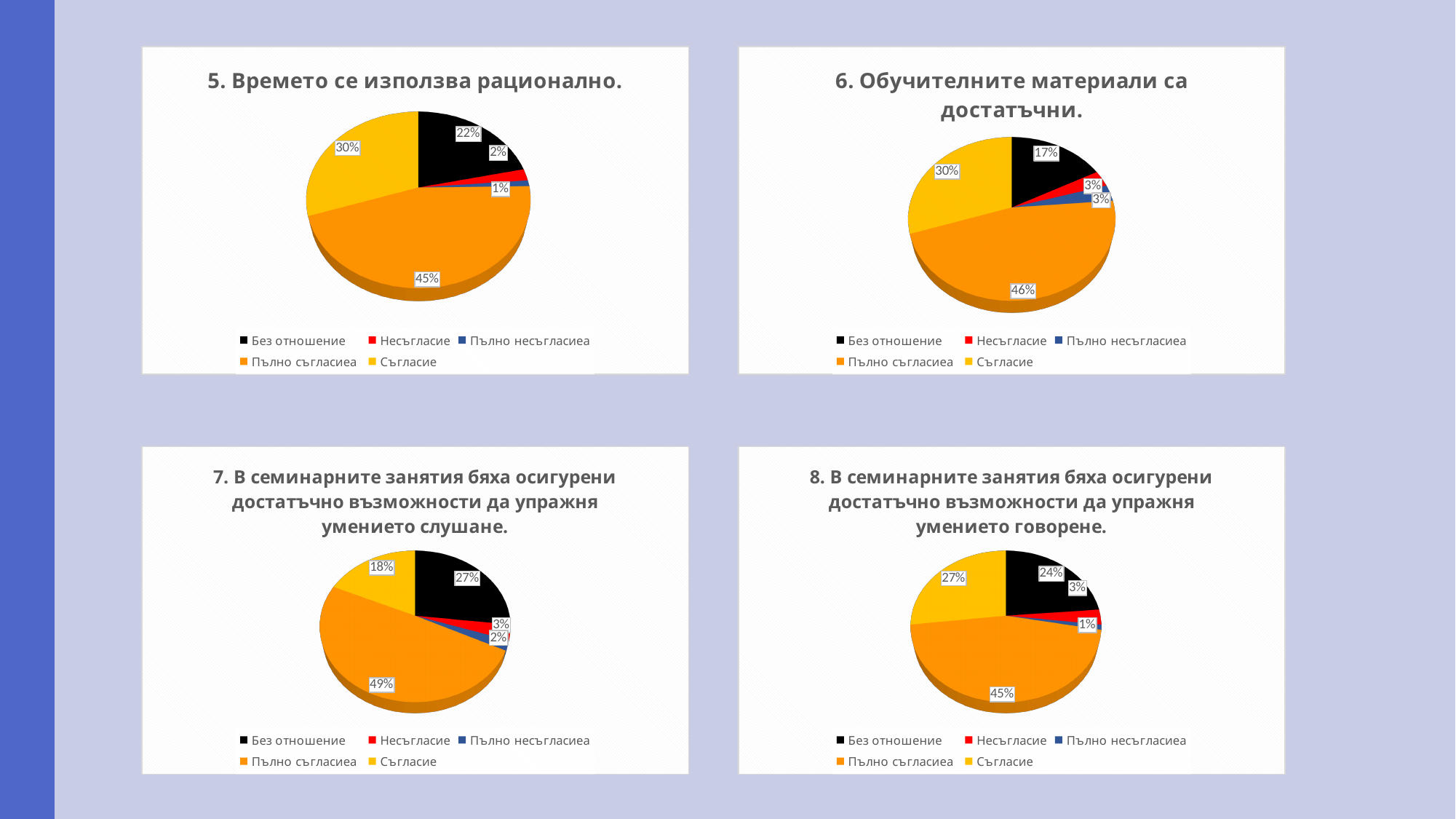
In the chart titled "6. Обучителните материали са достатъчни.", which category has the largest slice? Пълно съгласиеа In the chart titled "8. В семинарните занятия бяха осигурени достатъчно възможности да упражня умението говорене.", what is the value for "Пълно несъгласиеа"? 1% In the chart titled "8. В семинарните занятия бяха осигурени достатъчно възможности да упражня умението говорене.", which colour represents "Съгласие"? Yellow How many categories does the legend list in the chart titled "5. Времето се използва рационално."? 5 In the chart titled "5. Времето се използва рационално.", what share does "Пълно съгласиеа" have? 45% In the chart titled "7. В семинарните занятия бяха осигурени достатъчно възможности да упражня умението слушане.", what is the value for "Съгласие"? 18% In the chart titled "8. В семинарните занятия бяха осигурени достатъчно възможности да упражня умението говорене.", what is the difference between "Без отношение" and "Съгласие"? 3% What type of chart is the chart titled "7. В семинарните занятия бяха осигурени достатъчно възможности да упражня умението слушане."? Pie chart In the chart titled "5. Времето се използва рационално.", which category has the smallest slice? Пълно несъгласиеа In the chart titled "7. В семинарните занятия бяха осигурени достатъчно възможности да упражня умението слушане.", which is larger, "Без отношение" or "Съгласие"? Без отношение In the chart titled "6. Обучителните материали са достатъчни.", what is the value for "Без отношение"? 17% In the chart titled "6. Обучителните материали са достатъчни.", what is the difference between "Пълно съгласиеа" and "Съгласие"? 16%